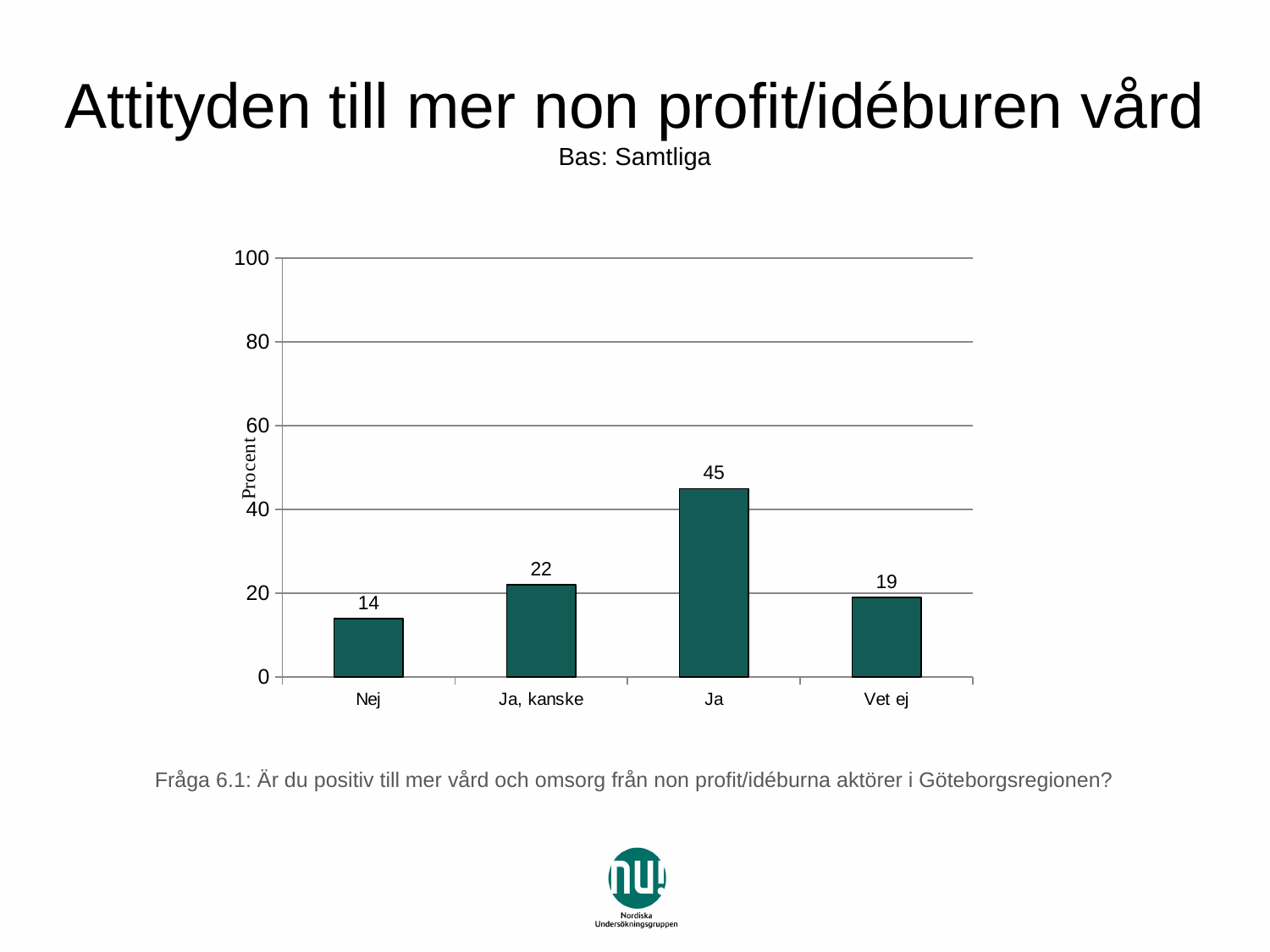
Which category has the highest value? Ja What is the difference between the values for "Ja" and "Nej"? 31 What is the value for "Nej"? 14 What is the label of the vertical axis? Procent Which category has the lowest value? Nej What is the value for "Ja"? 45 How many categories are shown on the x axis? 4 Which is larger, the value for "Ja, kanske" or the value for "Vet ej"? Ja, kanske Is the value for "Ja" greater or less than 40? greater What is the value for "Vet ej"? 19 What kind of chart is shown on the slide? bar chart What is the value for "Ja, kanske"? 22